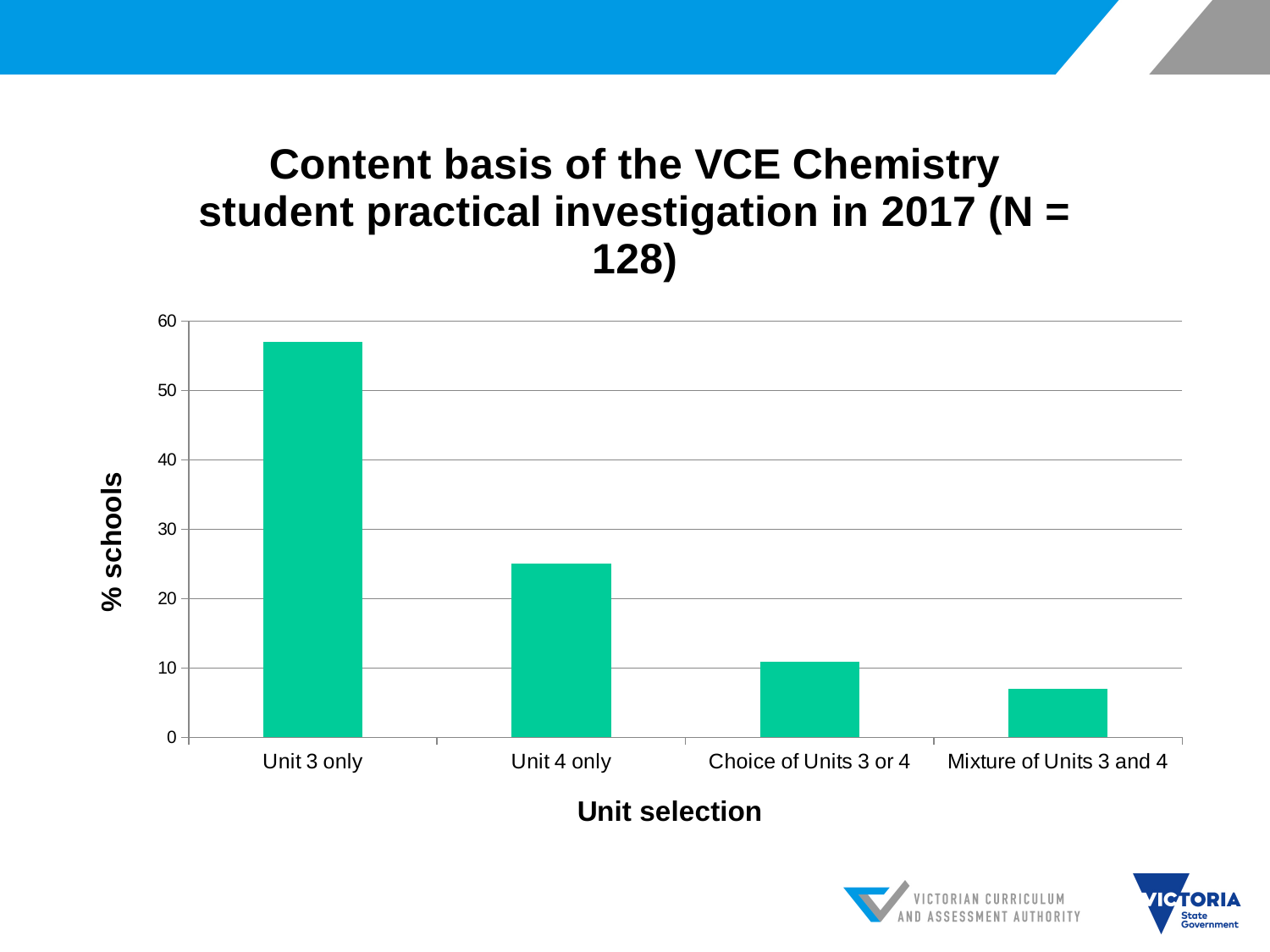
Do the values rise or fall moving left to right along the x axis? fall What is the label of the y axis? % schools Is the value for Unit 3 only greater or less than 50? greater Is the value for Mixture of Units 3 and 4 greater or less than 10? less Is the value for Choice of Units 3 or 4 greater or less than 20? less How many categories are shown on the x axis? 4 Which unit selection has the lowest percentage of schools? Mixture of Units 3 and 4 Which unit selection has the highest percentage of schools? Unit 3 only What kind of chart is shown on the slide? bar chart Which is larger, the value for Unit 4 only or the value for Choice of Units 3 or 4? Unit 4 only